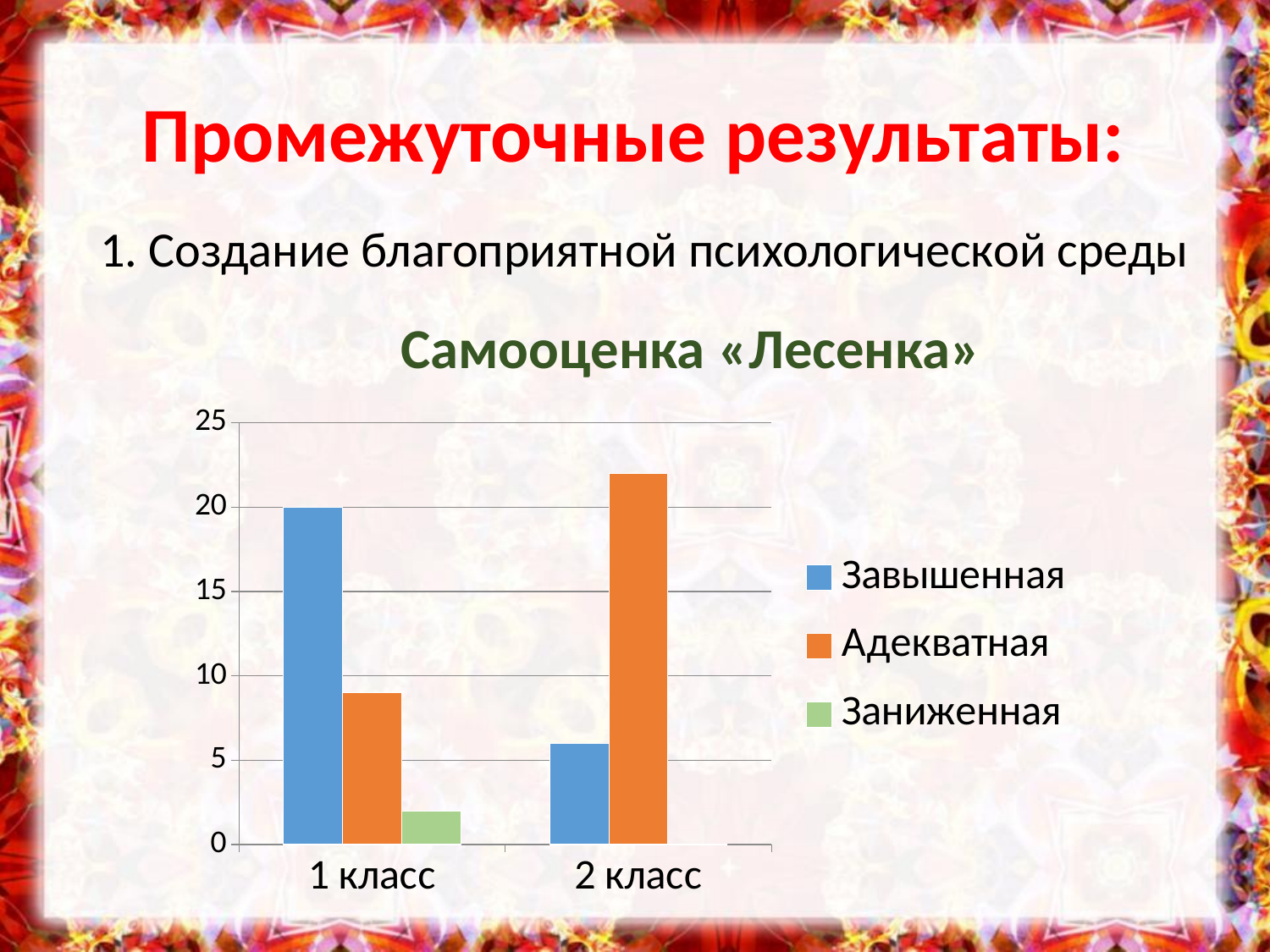
How many series does the legend list? 3 Is the value for Адекватная in 1 класс greater or less than 10? less How many categories are shown on the x axis? 2 What is the title of the chart? Самооценка «Лесенка» Is the value for Адекватная in 2 класс greater or less than 20? greater Which series has the lowest value in 1 класс? Заниженная Is the value for Завышенная in 2 класс greater or less than 10? less What is the value for Завышенная in 1 класс? 20 Which is larger: Завышенная in 1 класс or Завышенная in 2 класс? Завышенная in 1 класс Which series has the highest value in 2 класс? Адекватная What kind of chart is shown on the slide? bar chart